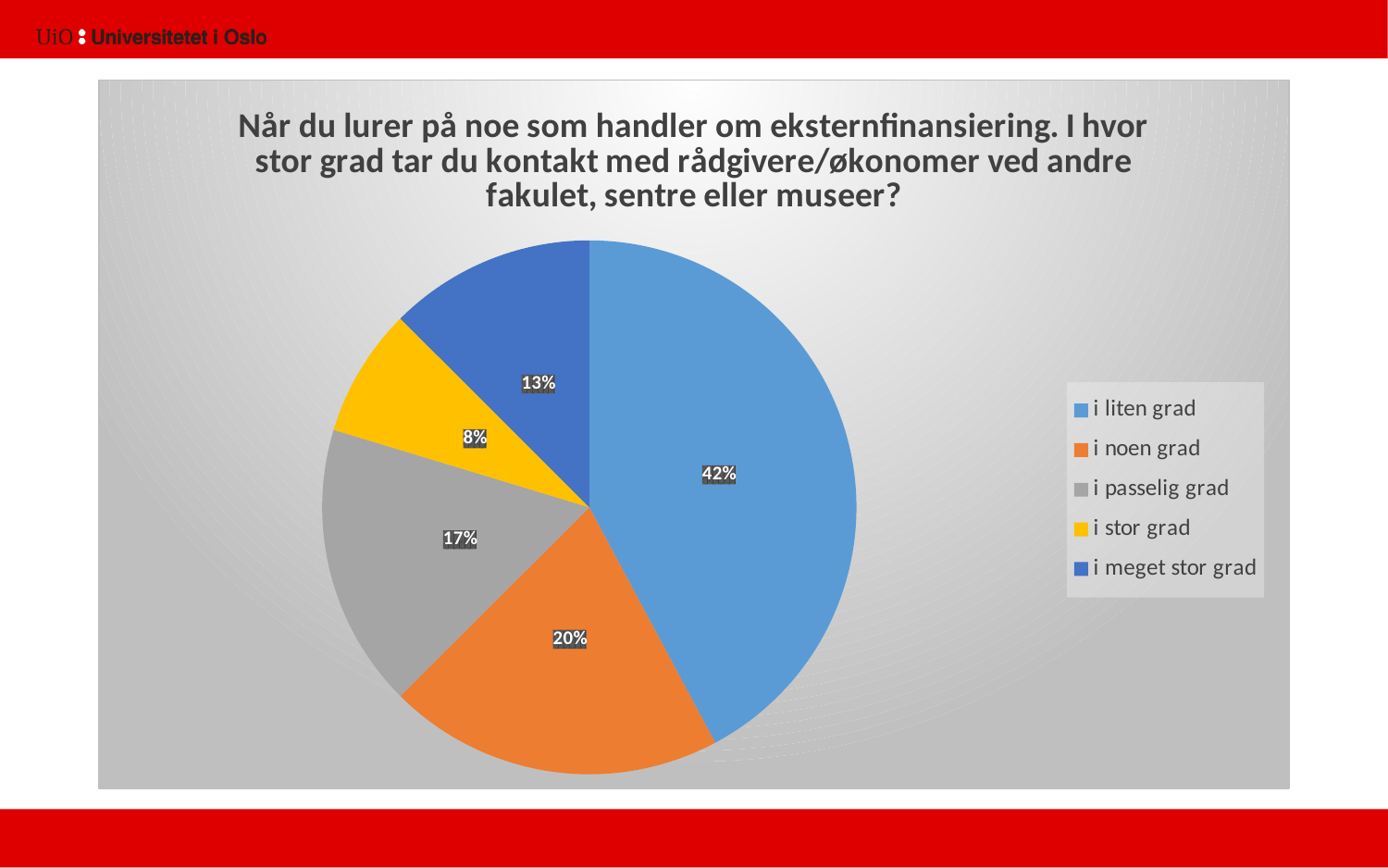
Which category has the largest slice of the pie? i liten grad Which category has the smallest slice of the pie? i stor grad What share of the pie is 'i liten grad'? 42% How many categories does the legend list? 5 What kind of chart is shown on the slide? pie chart What share of the pie is 'i noen grad'? 20% What share of the pie is 'i stor grad'? 8% What is the difference in percentage points between 'i liten grad' and 'i noen grad'? 22 What colour is the slice for 'i stor grad'? yellow Which is larger, the slice for 'i passelig grad' or the slice for 'i meget stor grad'? i passelig grad